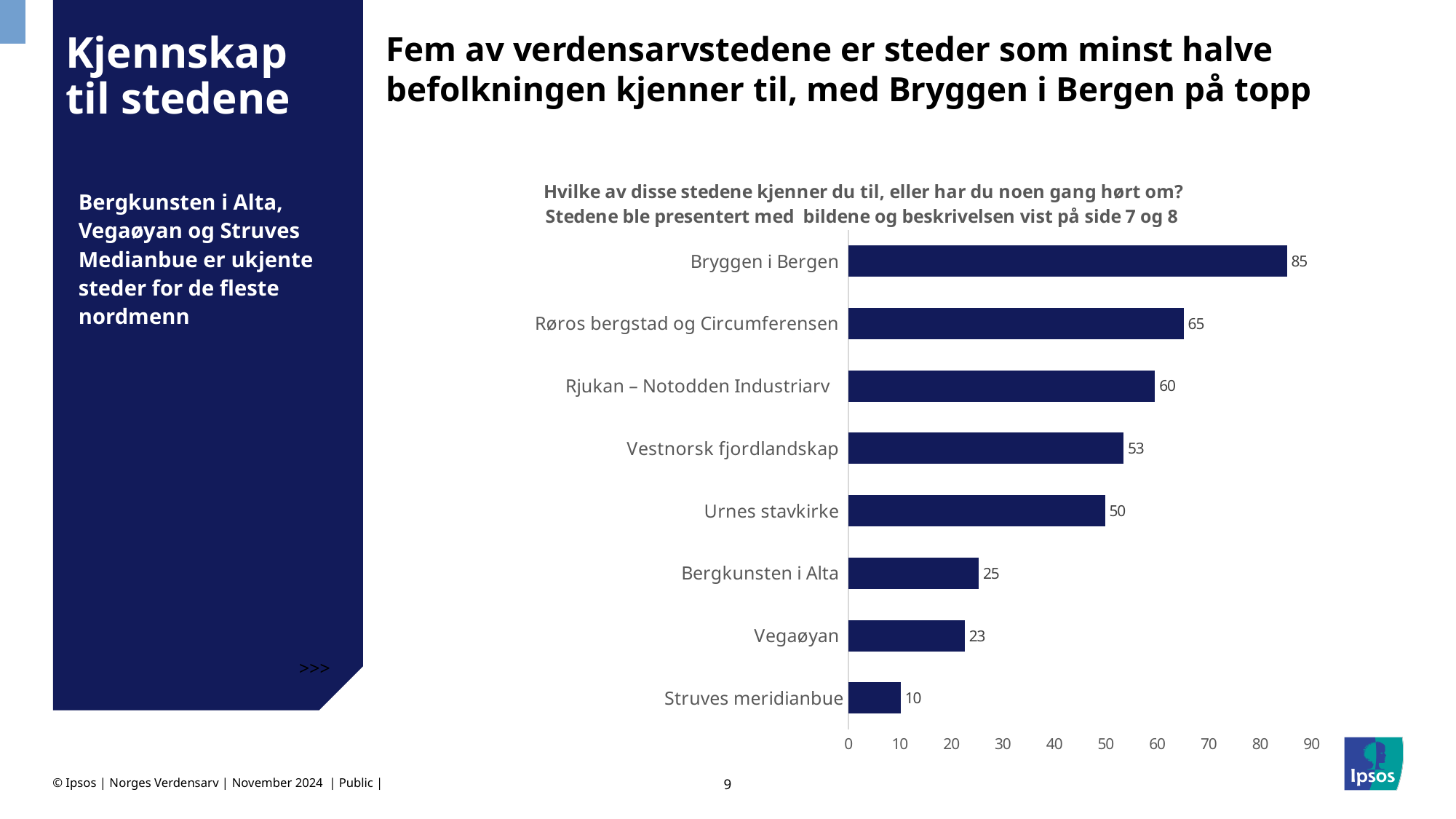
What kind of chart is shown on the slide? bar chart Which category has the lowest value? Struves meridianbue What is the value for Bryggen i Bergen? 85 What is the value for Vegaøyan? 23 What is the difference between the values for Bryggen i Bergen and Røros bergstad og Circumferensen? 20 Which category has the highest value? Bryggen i Bergen What is the value for Urnes stavkirke? 50 Is the value for Vestnorsk fjordlandskap greater or less than 40? greater What is the difference between the values for Bergkunsten i Alta and Struves meridianbue? 15 What is the highest value shown on the x axis? 90 How many categories are shown in the chart? 8 Which is larger, the value for Rjukan – Notodden Industriarv or the value for Vestnorsk fjordlandskap? Rjukan – Notodden Industriarv